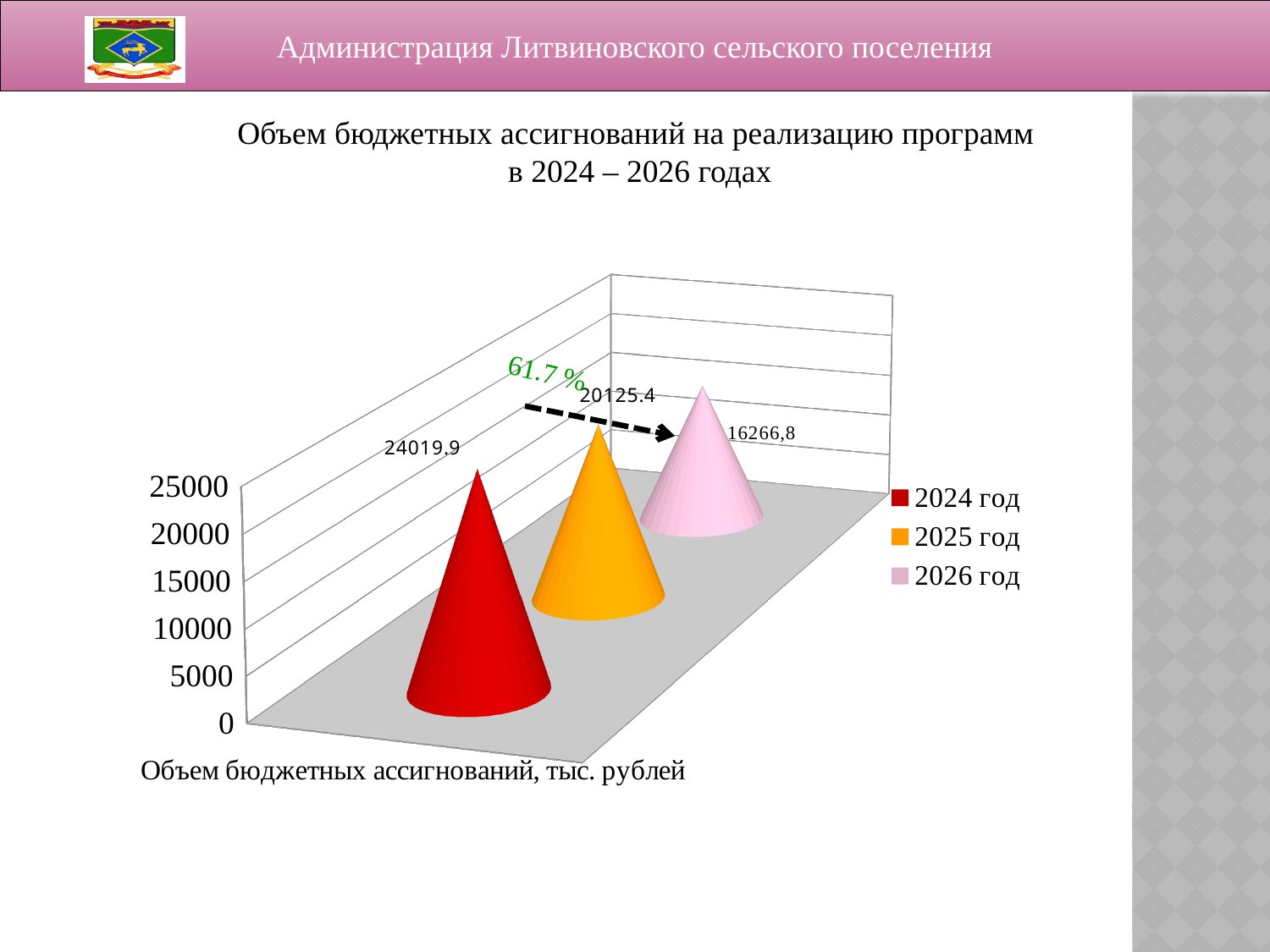
What is the value for 2025 год? 20125.4 What is the difference between the values for 2024 год and 2025 год? 3894.5 What percentage is written next to the dashed arrow on the chart? 61.7 % Which year has the highest value? 2024 год Which year has the lowest value? 2026 год What is the value for 2026 год? 16266,8 Is the value for 2025 год greater or less than 20000? greater Do the values rise or fall from 2024 год to 2026 год? fall Which is larger, the value for 2025 год or the value for 2026 год? 2025 год How many series does the legend list? 3 What is the value for 2024 год? 24019.9 What is the difference between the values for 2024 год and 2026 год? 7753.1